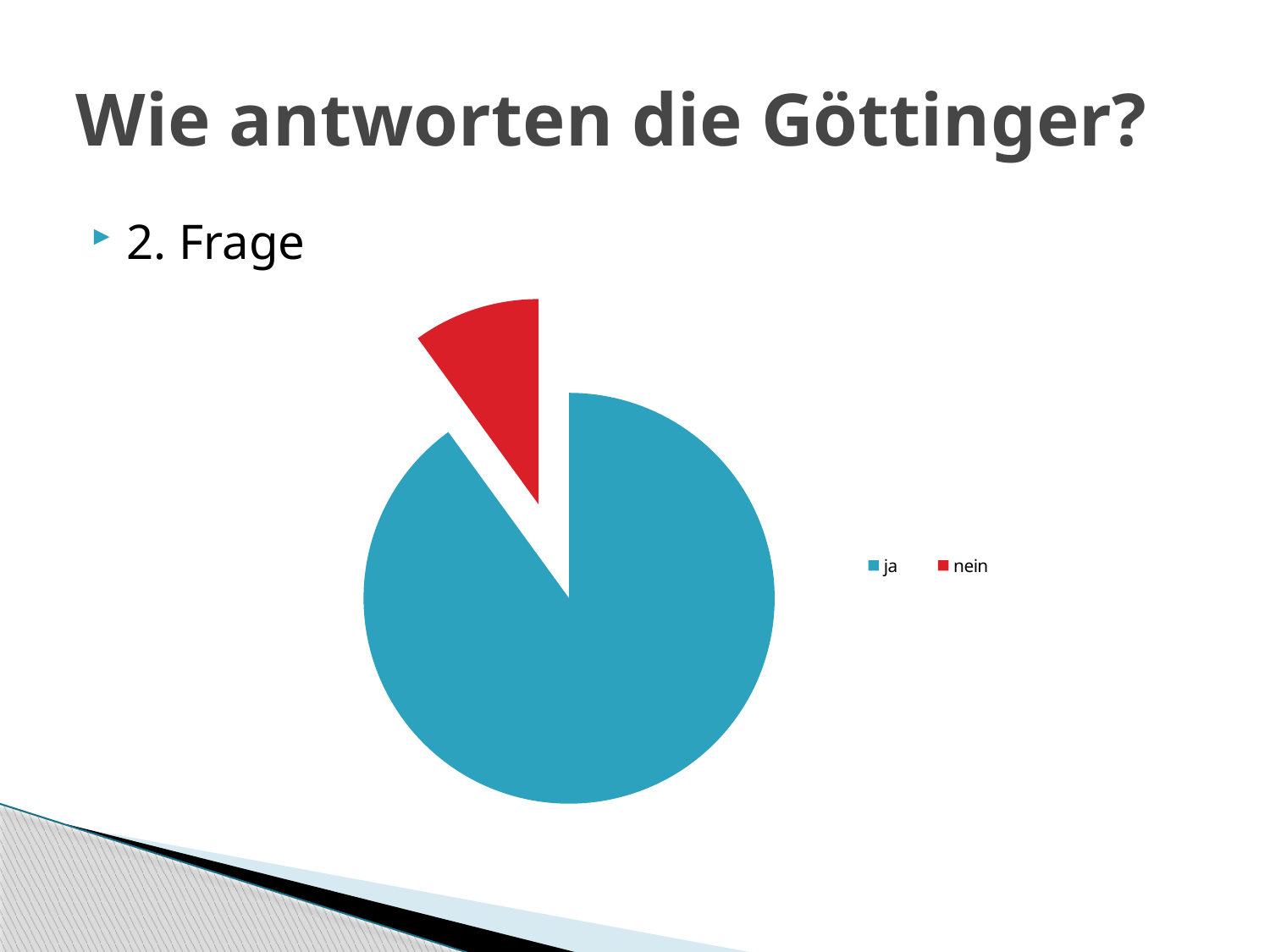
What colour is the slice for nein in the pie chart? red Which slice is larger in the pie chart, ja or nein? ja How many slices does the pie chart have? 2 Which category has the smallest slice in the pie chart? nein How many entries does the legend of the pie chart list? 2 What kind of chart is shown on the slide? pie chart Which category has the largest slice in the pie chart? ja What colour is the slice for ja in the pie chart? blue